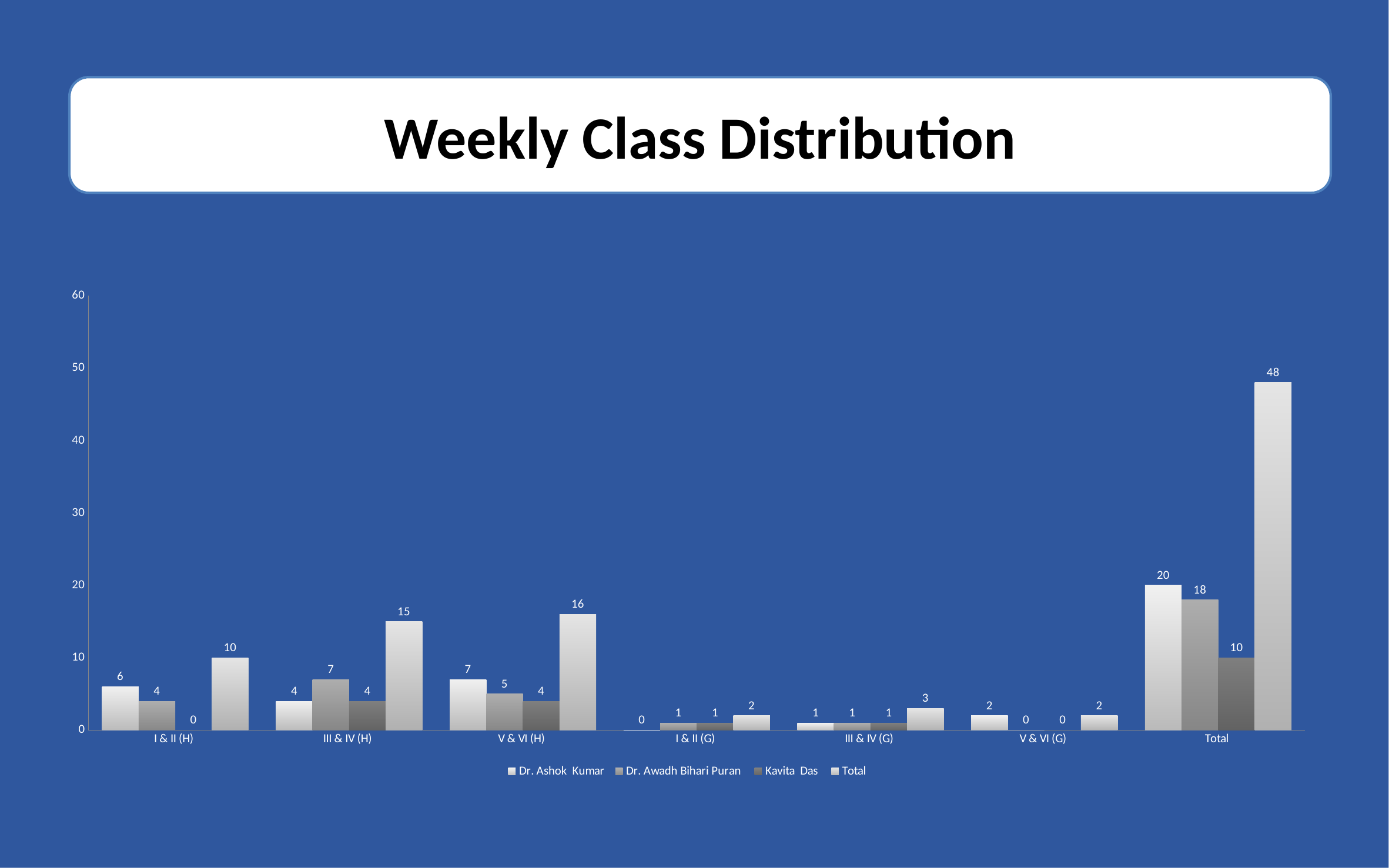
How many series does the legend list? 4 What is the difference between the Total values for V & VI (H) and III & IV (H)? 1 What is the title of the slide? Weekly Class Distribution How many categories are shown on the x axis? 7 What kind of chart is shown on the slide? Bar chart What is the Total value for the V & VI (H) category? 16 What is the value for Kavita Das in the Total category? 10 Which category has the highest Total value? Total Which is larger: Dr. Ashok Kumar's value in the Total category or Dr. Awadh Bihari Puran's value in the Total category? Dr. Ashok Kumar What is the value for Dr. Ashok Kumar in the I & II (H) category? 6 What is the value for Dr. Awadh Bihari Puran in the III & IV (H) category? 7